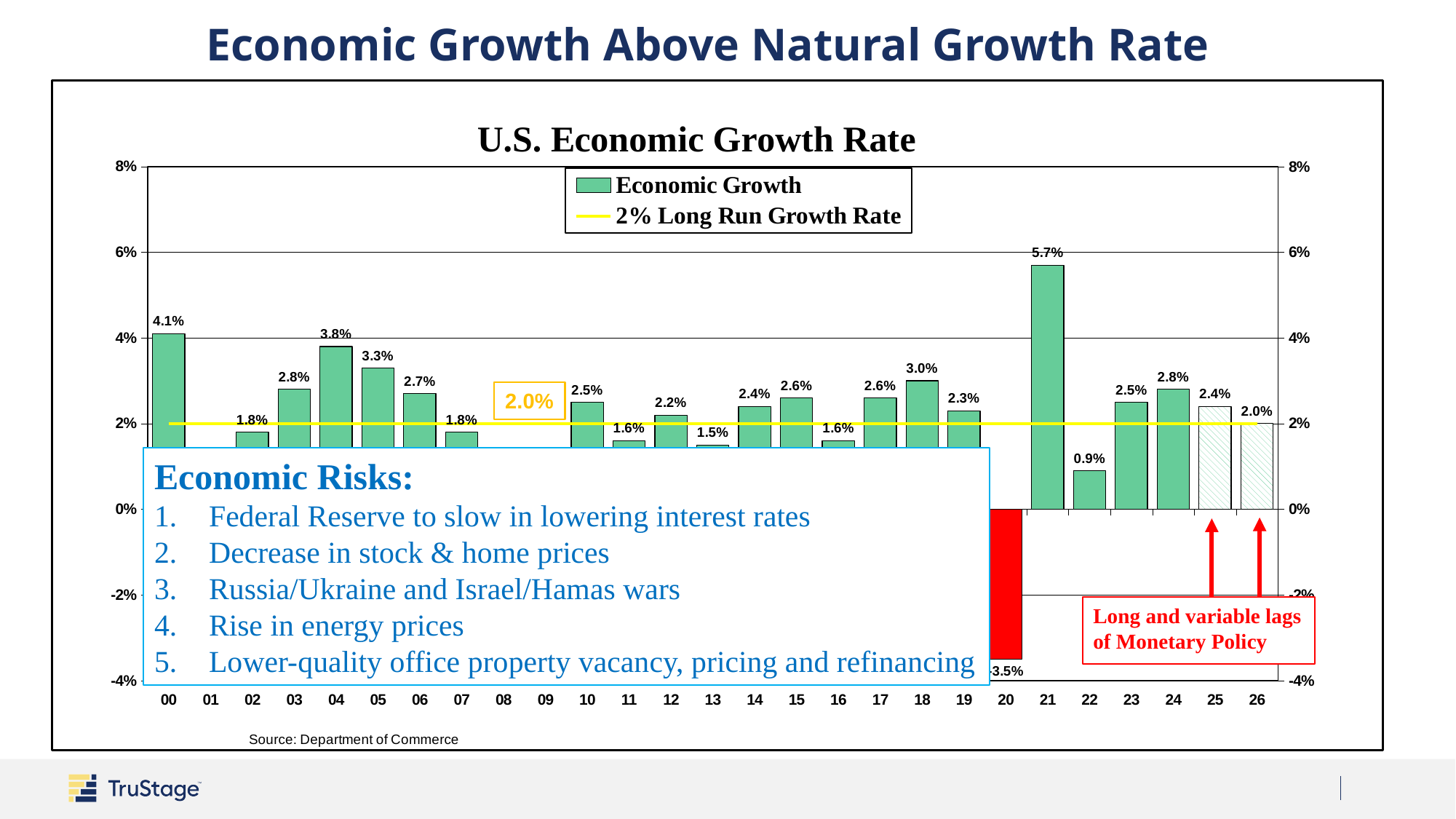
Is the value for 21 greater or less than 4%? greater Which year has the lowest economic growth rate? 20 How many series does the legend list? 2 How many years are shown on the x axis? 27 What kind of chart is used to show the economic growth rate? Bar chart What is the economic growth rate shown for 21? 5.7% Which year has the higher growth rate, 18 or 19? 18 Which year has the highest economic growth rate? 21 What is the economic growth rate shown for 04? 3.8% What is the difference between the growth rates for 21 and 22? 4.8 percentage points What is the difference between the growth rates for 24 and 25? 0.4 percentage points What is the economic growth rate shown for 26? 2.0%